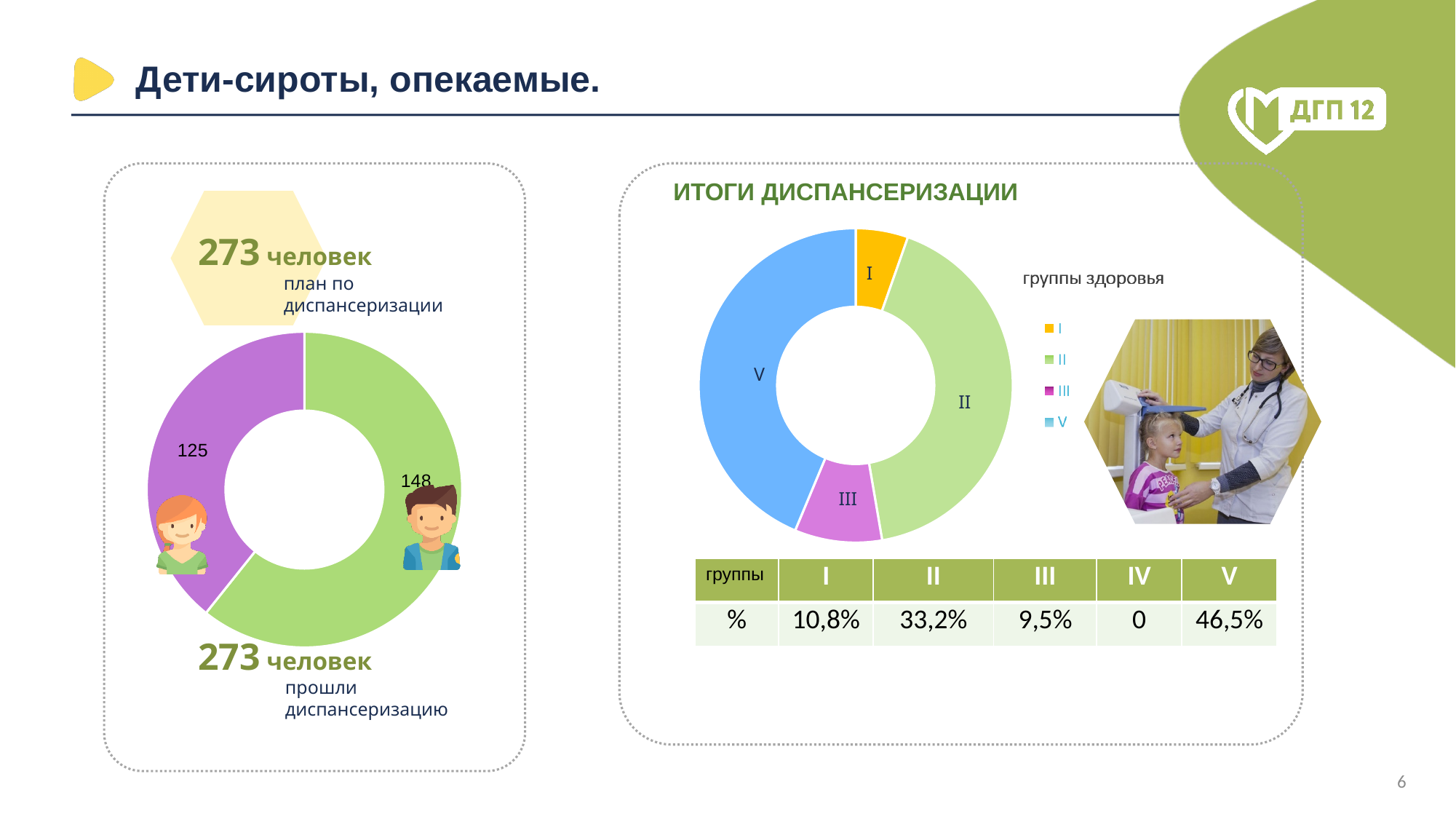
On the left donut chart, what value is shown for the green segment? 148 On the left donut chart, what is the difference between the green segment (148) and the purple segment (125)? 23 On the left donut chart, which segment is larger, the green one or the purple one? green On the chart titled ИТОГИ ДИСПАНСЕРИЗАЦИИ, which health group has the largest share? V On the chart titled ИТОГИ ДИСПАНСЕРИЗАЦИИ, what percentage is shown for group II? 33,2% On the chart titled ИТОГИ ДИСПАНСЕРИЗАЦИИ, what colour is the slice for group I? yellow (orange) On the left donut chart, what value is shown for the purple segment? 125 What kind of chart is shown on the left side of the slide? donut (pie) chart On the chart titled ИТОГИ ДИСПАНСЕРИЗАЦИИ, what percentage is shown for group V? 46,5% On the left donut chart, what is the total of the two segments (148 and 125)? 273 How many entries does the legend of the chart titled ИТОГИ ДИСПАНСЕРИЗАЦИИ list? 4